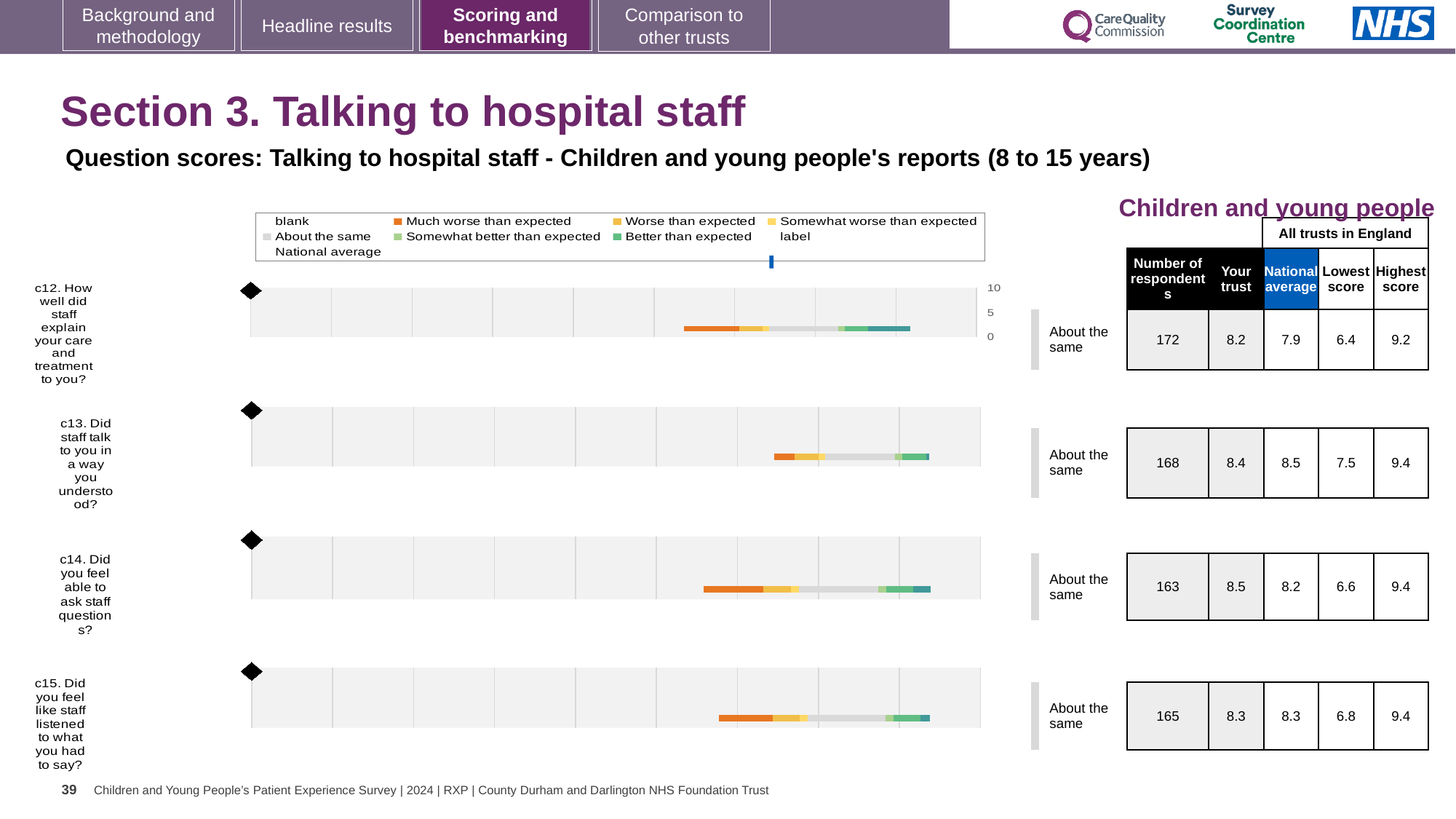
How many question rows (charts) are shown on the slide? 4 Which question has the highest 'Your trust' score? c14 For c15 (Did you feel like staff listened to what you had to say?), how many respondents were there? 165 For c13, which is larger: the 'Your trust' score or the national average? National average Which question has the most respondents? c12 For c14, what is the difference between the 'Your trust' score and the national average? 0.3 For c13 (Did staff talk to you in a way you understood?), what is the national average score? 8.5 What kind of chart is used for each question row on the slide? bar chart What benchmark category is shown next to each of the four question charts? About the same For c14 (Did you feel able to ask staff questions?), what is the lowest score among all trusts in England? 6.6 Which question has the lowest 'Your trust' score? c12 For c12 (How well did staff explain your care and treatment to you?), what is the 'Your trust' score? 8.2